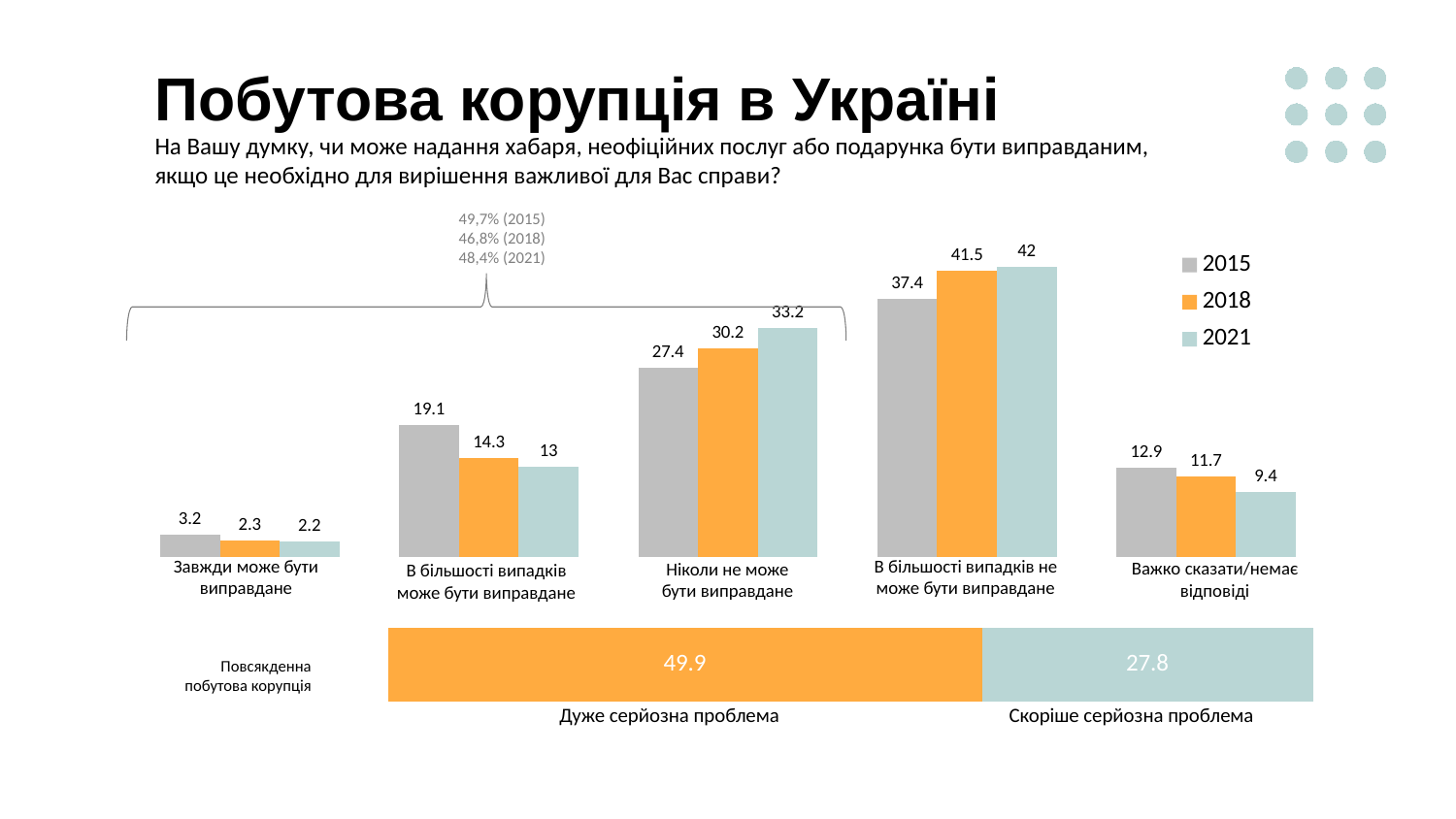
In the upper grouped bar chart, do the values for "Важко сказати/немає відповіді" rise or fall from 2015 to 2021? fall In the upper grouped bar chart, which category has the highest 2021 value? В більшості випадків не може бути виправдане In the bottom stacked bar "Повсякденна побутова корупція", what is the value for "Дуже серйозна проблема"? 49.9 In the upper grouped bar chart, how many categories are shown on the x axis? 5 In the upper grouped bar chart, what is the 2015 value for "В більшості випадків може бути виправдане"? 19.1 In the upper grouped bar chart, how many series does the legend list? 3 In the upper grouped bar chart, what is the 2021 value for "Ніколи не може бути виправдане"? 33.2 In the bottom stacked bar "Повсякденна побутова корупція", what is the total of the two segments? 77.7 In the upper grouped bar chart, which is larger for "В більшості випадків може бути виправдане": the 2015 value or the 2021 value? 2015 In the upper grouped bar chart, which category has the lowest 2015 value? Завжди може бути виправдане In the upper grouped bar chart, what is the 2018 value for "Важко сказати/немає відповіді"? 11.7 In the upper grouped bar chart, what is the difference between the 2021 and 2015 values for "Ніколи не може бути виправдане"? 5.8